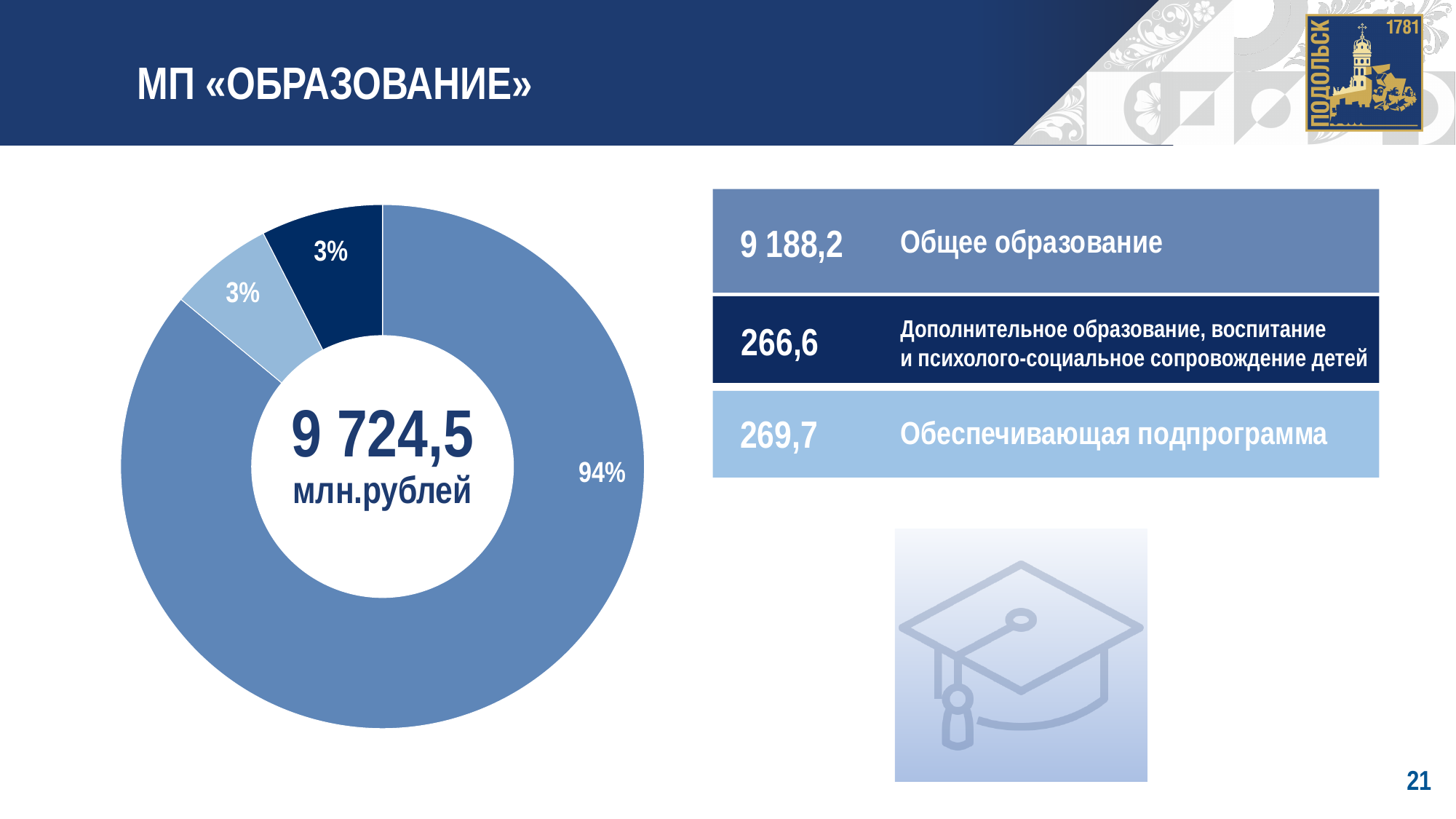
What is the value shown for «Общее образование»? 9 188,2 What is the title of the slide containing the chart? МП «ОБРАЗОВАНИЕ» How many slices does the donut chart have? 3 What share of the donut chart does the largest slice represent? 94% What is the value shown for «Обеспечивающая подпрограмма»? 269,7 Which category has the lowest value? Дополнительное образование, воспитание и психолого-социальное сопровождение детей What is the value shown for «Дополнительное образование, воспитание и психолого-социальное сопровождение детей»? 266,6 What kind of chart is shown on the slide? Pie chart (donut) Which category has the highest value? Общее образование What is the difference between the values for «Обеспечивающая подпрограмма» and «Дополнительное образование, воспитание и психолого-социальное сопровождение детей»? 3,1 What total amount is shown in the centre of the donut chart? 9 724,5 млн.рублей Which is larger: the value for «Обеспечивающая подпрограмма» or for «Дополнительное образование, воспитание и психолого-социальное сопровождение детей»? Обеспечивающая подпрограмма